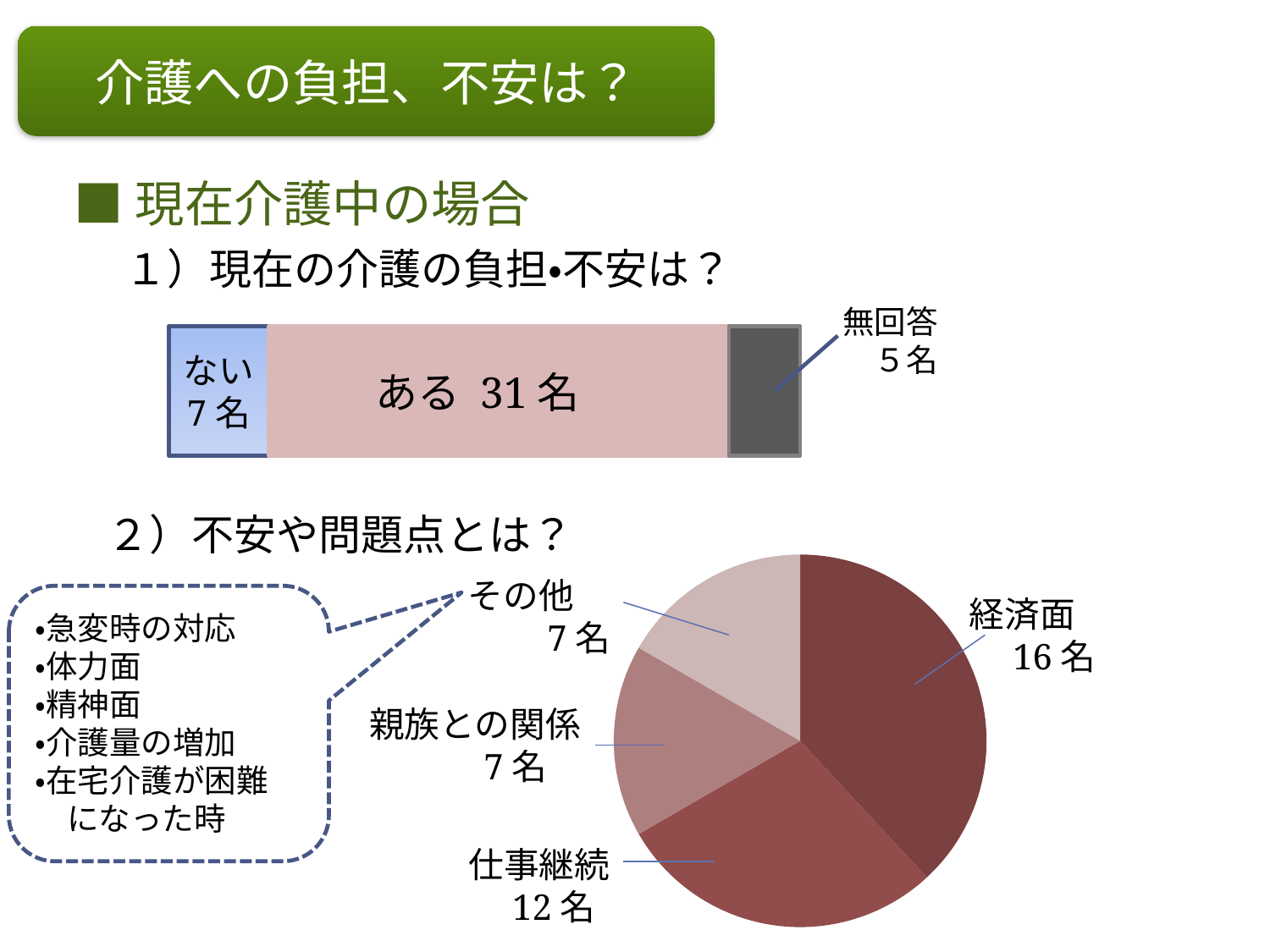
How many slices does the pie chart for 2）不安や問題点とは？ have? 4 In the stacked bar for 1）現在の介護の負担•不安は？, which segment is the smallest? 無回答 What is the total of the stacked bar for 1）現在の介護の負担•不安は？? 43名 In the pie chart for 2）不安や問題点とは？, which is larger, 仕事継続 or 親族との関係? 仕事継続 In the pie chart for 2）不安や問題点とは？, how many people are in the 仕事継続 slice? 12名 What is the total number of people across all slices of the pie chart for 2）不安や問題点とは？? 42名 In the stacked bar for 1）現在の介護の負担•不安は？, how many people answered 無回答? 5名 In the pie chart for 2）不安や問題点とは？, what is the difference between 経済面 and 仕事継続? 4名 In the pie chart for 2）不安や問題点とは？, how many people are in the 経済面 slice? 16名 In the stacked bar for 1）現在の介護の負担•不安は？, how many people answered ある? 31名 In the pie chart for 2）不安や問題点とは？, which category has the largest slice? 経済面 What kind of chart is used for 2）不安や問題点とは？? Pie chart